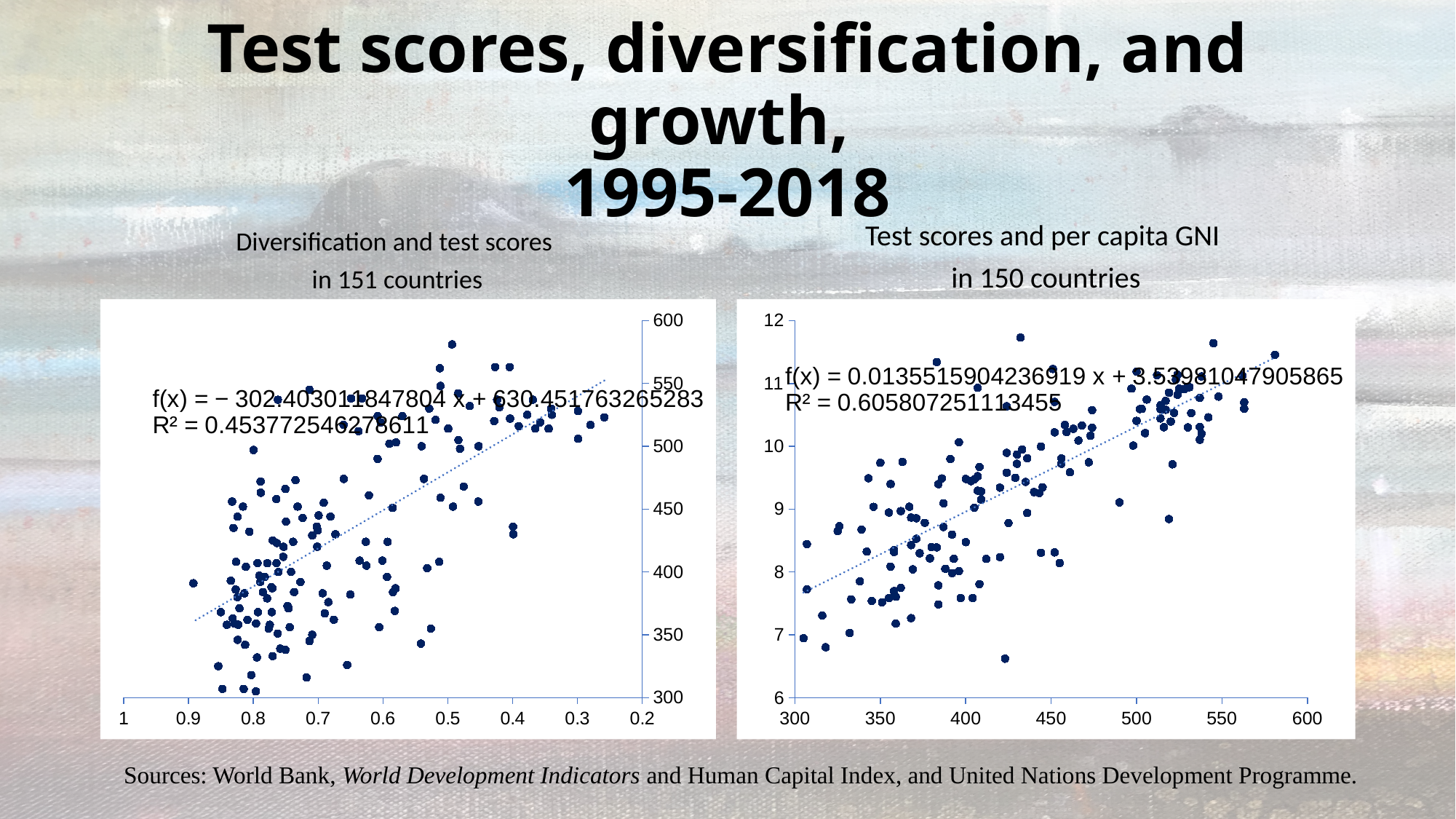
Which chart has the higher R² value, the left chart 'Diversification and test scores' or the right chart 'Test scores and per capita GNI'? Test scores and per capita GNI What kind of chart is the right chart, 'Test scores and per capita GNI in 150 countries'? scatter chart According to its title, how many countries are plotted in the right chart, 'Test scores and per capita GNI'? 150 According to its title, how many countries are plotted in the left chart, 'Diversification and test scores'? 151 What is the intercept of the trend line equation shown on the left chart, 'Diversification and test scores'? 630.451763265283 In the right chart, 'Test scores and per capita GNI', do the values generally rise or fall as the x axis increases from 300 to 600? rise What is the R² value shown on the right chart, 'Test scores and per capita GNI'? 0.605807251113455 In the right chart, 'Test scores and per capita GNI', is the highest plotted point greater or less than 11 on the y axis? greater What kind of chart is the left chart, 'Diversification and test scores in 151 countries'? scatter chart What is the R² value shown on the left chart, 'Diversification and test scores'? 0.453772546278611 What is the slope of the trend line equation shown on the right chart, 'Test scores and per capita GNI'? 0.0135515904236919 In the left chart, 'Diversification and test scores', is the lowest plotted point greater or less than 350 on the y axis? less